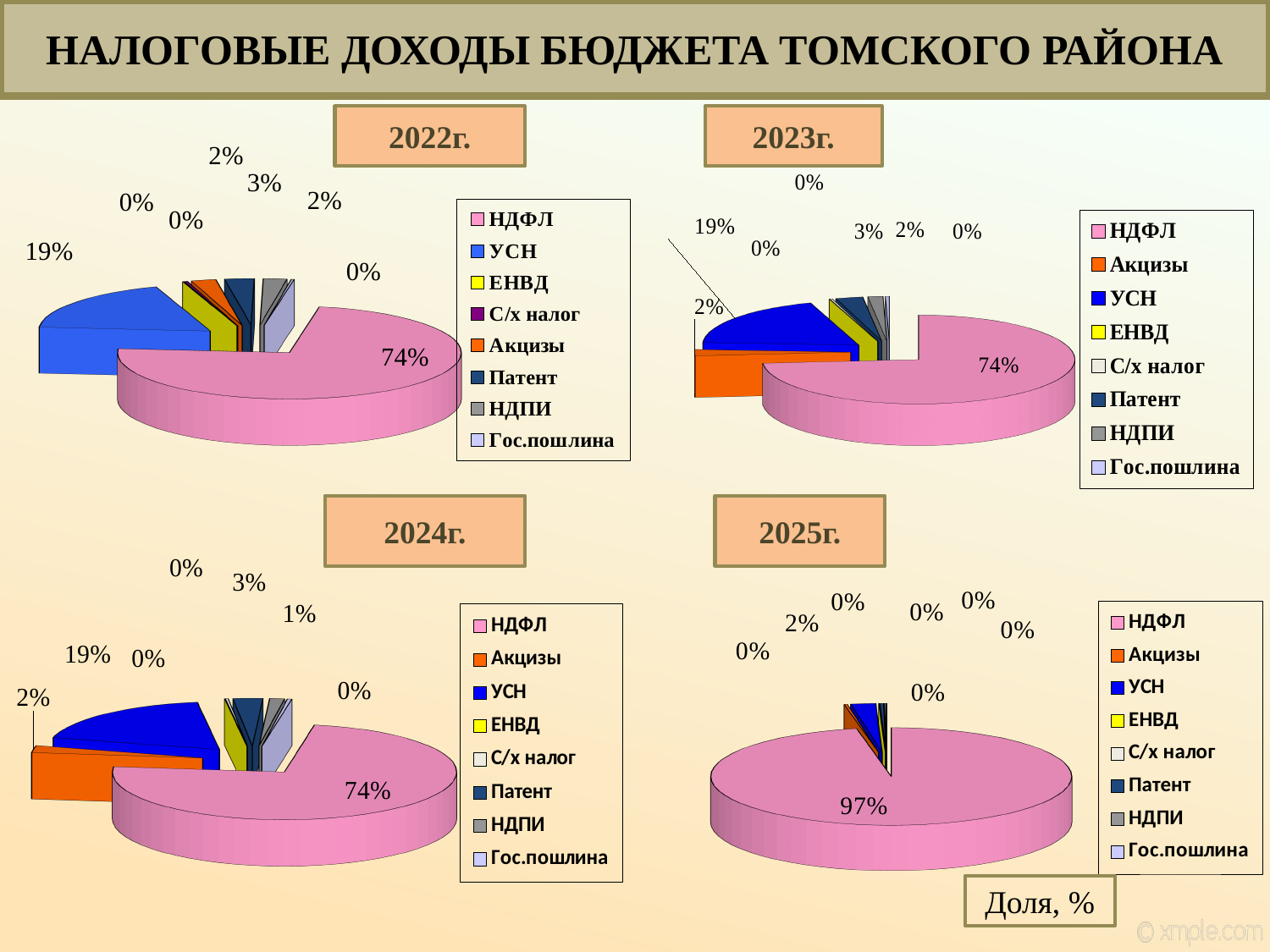
In the 2024г. chart, what is the difference between the НДФЛ share and the УСН share? 55% In the 2023г. chart, what share does НДФЛ have? 74% In the 2022г. chart, what share does УСН have? 19% In the 2022г. chart, which is larger, НДФЛ or УСН? НДФЛ What kind of chart is used for the 2022г. data? pie chart In the 2024г. chart, what share does УСН have? 19% How many entries does the legend of the 2023г. chart list? 8 In the 2025г. chart, which category has the largest slice? НДФЛ What is the title of the slide containing the four pie charts? НАЛОГОВЫЕ ДОХОДЫ БЮДЖЕТА ТОМСКОГО РАЙОНА